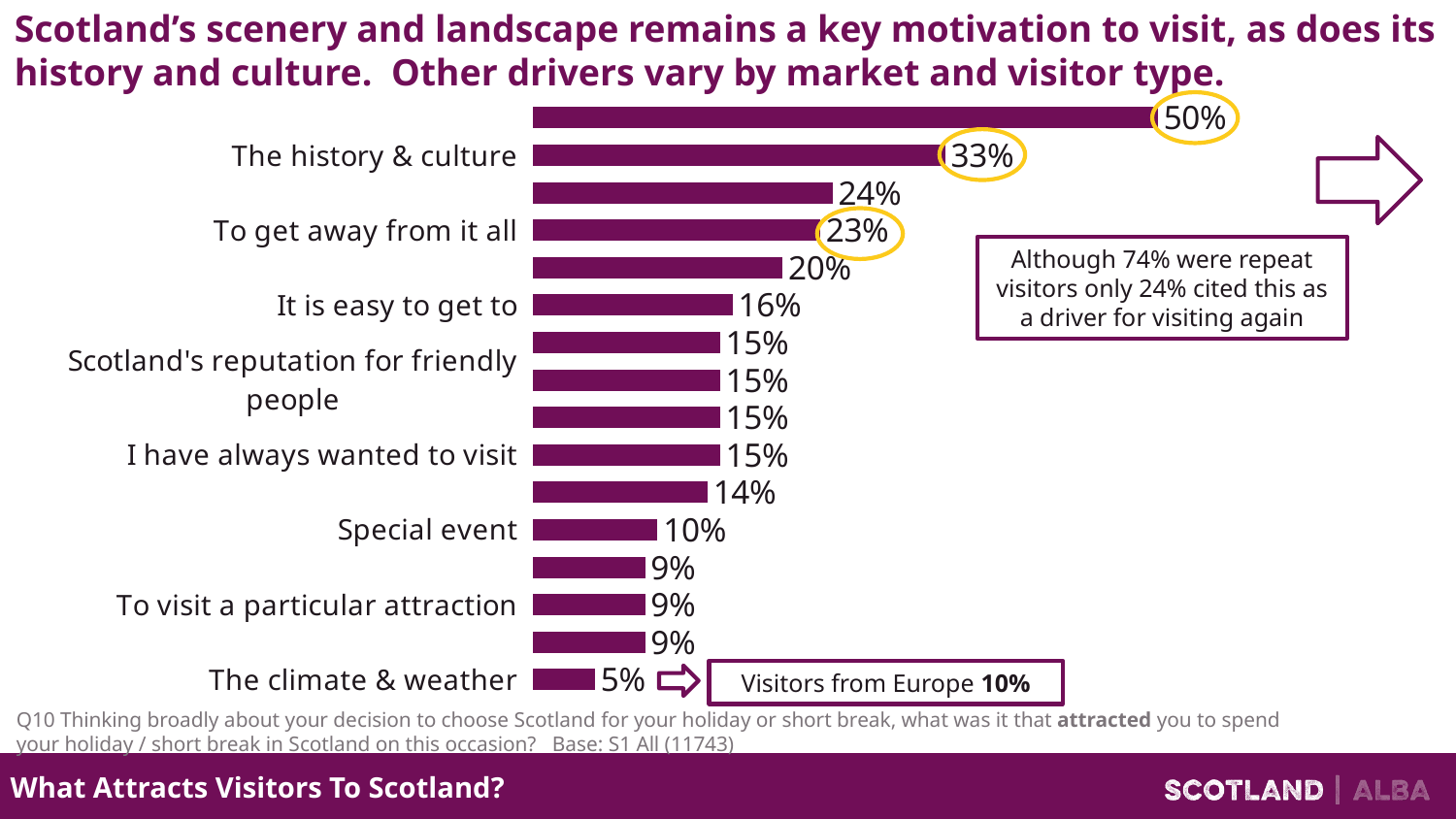
According to the callout box, what percentage of visitors from Europe cited the climate & weather? 10% How many bars are plotted on the chart? 16 What value is shown for "Special event"? 10% What is the difference in percentage points between "The history & culture" and "To get away from it all"? 10 What percentage is shown for "The history & culture"? 33% Which is larger: the value for "Special event" or the value for "To visit a particular attraction"? Special event What is the highest value shown on the chart? 50% What type of chart is shown on the slide? Bar chart Which labelled category has the lowest value on the chart? The climate & weather What value is shown for "To get away from it all"? 23% What percentage is shown for "The climate & weather"? 5% What percentage is shown for "It is easy to get to"? 16%